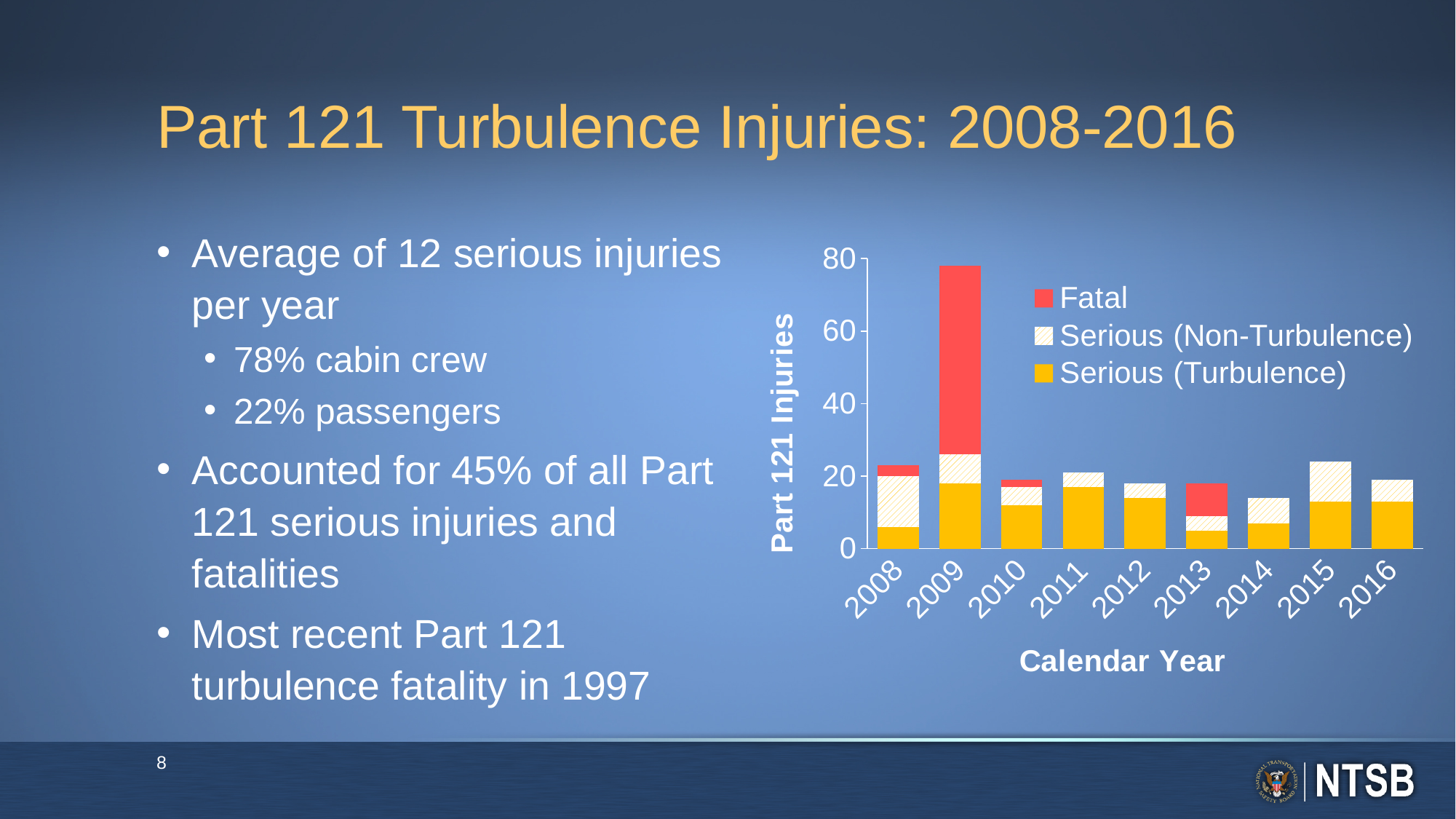
Is the total value for 2014 greater or less than 20? less How many series does the chart's legend list? 3 Which colour represents the Fatal series in the chart's legend? Red In how many calendar years does the chart show a Fatal segment? 4 Which calendar year has the highest total Part 121 injuries in the chart? 2009 Which year has the larger total Part 121 injuries, 2008 or 2009? 2009 Is the total value for 2009 greater or less than 60? greater What kind of chart is shown on the slide? Stacked bar chart How many calendar years are shown on the x axis of the chart? 9 Which calendar year has the lowest total Part 121 injuries in the chart? 2014 Is the total value for 2011 greater or less than 40? less What is the title of the chart's x axis? Calendar Year